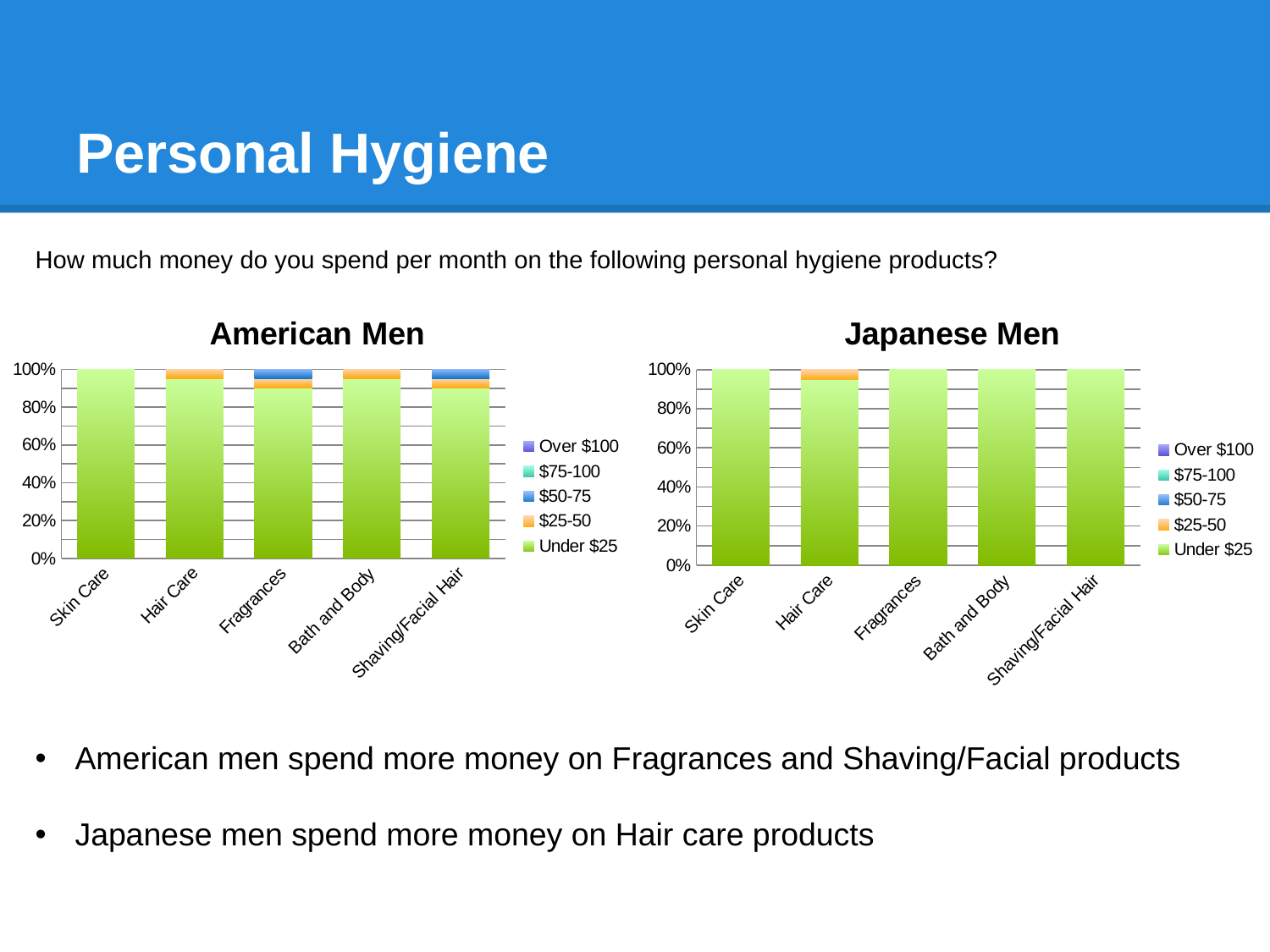
In the American Men chart, which is larger, the Under $25 value for Skin Care or for Fragrances? Skin Care In the American Men chart, is the $25-50 value for Fragrances greater or less than 20%? less How many categories are shown on the x axis of the Japanese Men chart? 5 What is the title of the chart on the right side of the slide? Japanese Men How many series does the legend of the American Men chart list? 5 What kind of chart is the American Men chart? Stacked bar chart In the Japanese Men chart, which category is the only one with a $25-50 segment? Hair Care In the American Men chart, which categories show a $50-75 segment? Fragrances and Shaving/Facial Hair In the Japanese Men chart, is the Under $25 value for Hair Care greater or less than 80%? greater In the American Men chart, which category has the lowest Under $25 share, Skin Care or Shaving/Facial Hair? Shaving/Facial Hair In the American Men chart, is the Under $25 value for Skin Care greater or less than 80%? greater What is the total of the stacked bar for Skin Care in the Japanese Men chart? 100%